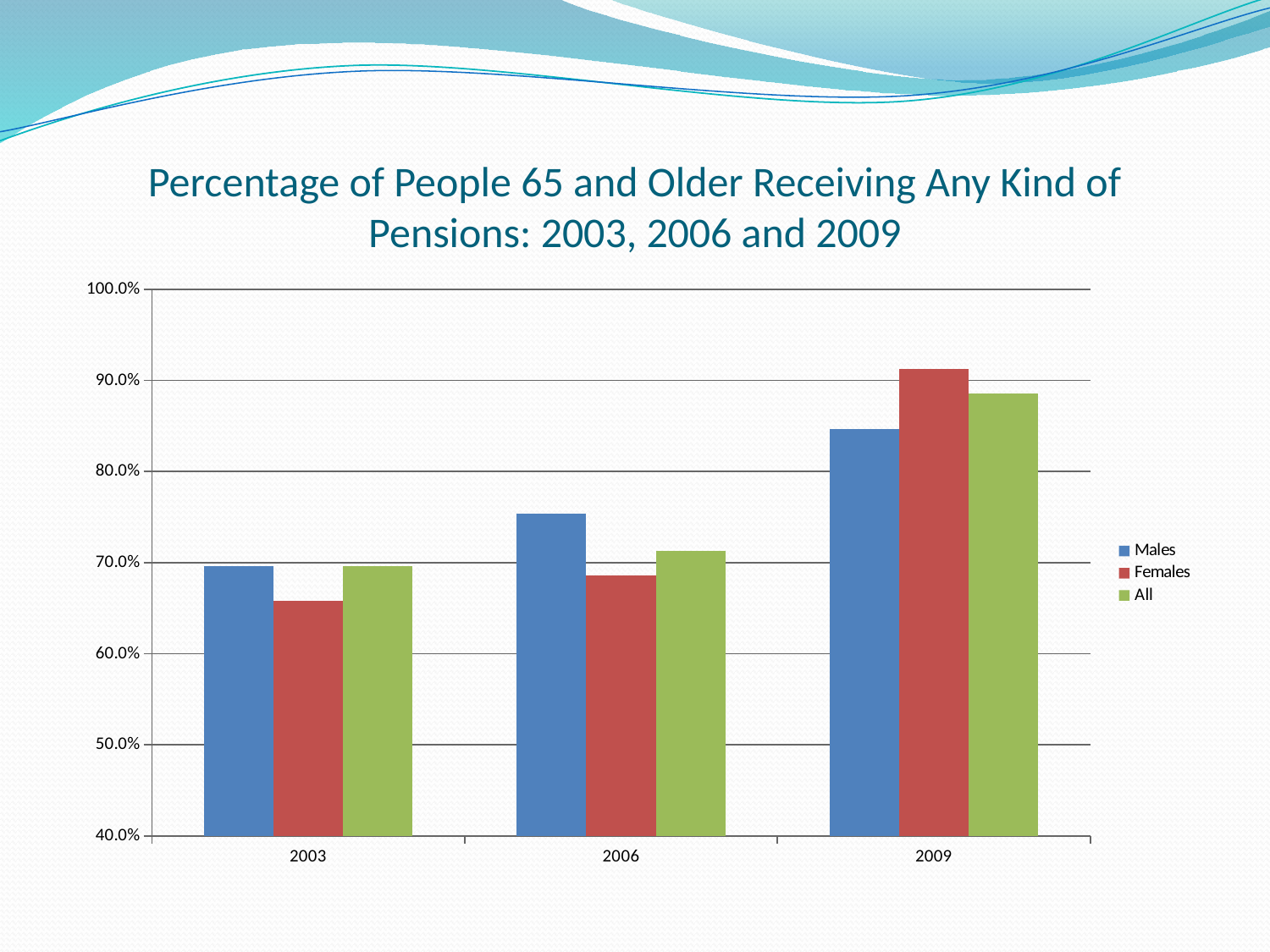
How many series does the legend list? 3 Is the value for Males in 2006 greater or less than 70.0%? greater How many years are shown on the x axis? 3 In which year is the value for Females lowest? 2003 Is the value for Females in 2003 greater or less than 70.0%? less In 2009, which is larger, the value for Females or the value for Males? Females What are the three entries listed in the legend? Males, Females, All In 2006, which is larger, the value for Males or the value for Females? Males In which year is the value for Females highest? 2009 Do the values for Males rise or fall from 2003 to 2009? Rise What kind of chart is shown on the slide? Bar chart Is the value for Females in 2009 greater or less than 90.0%? greater